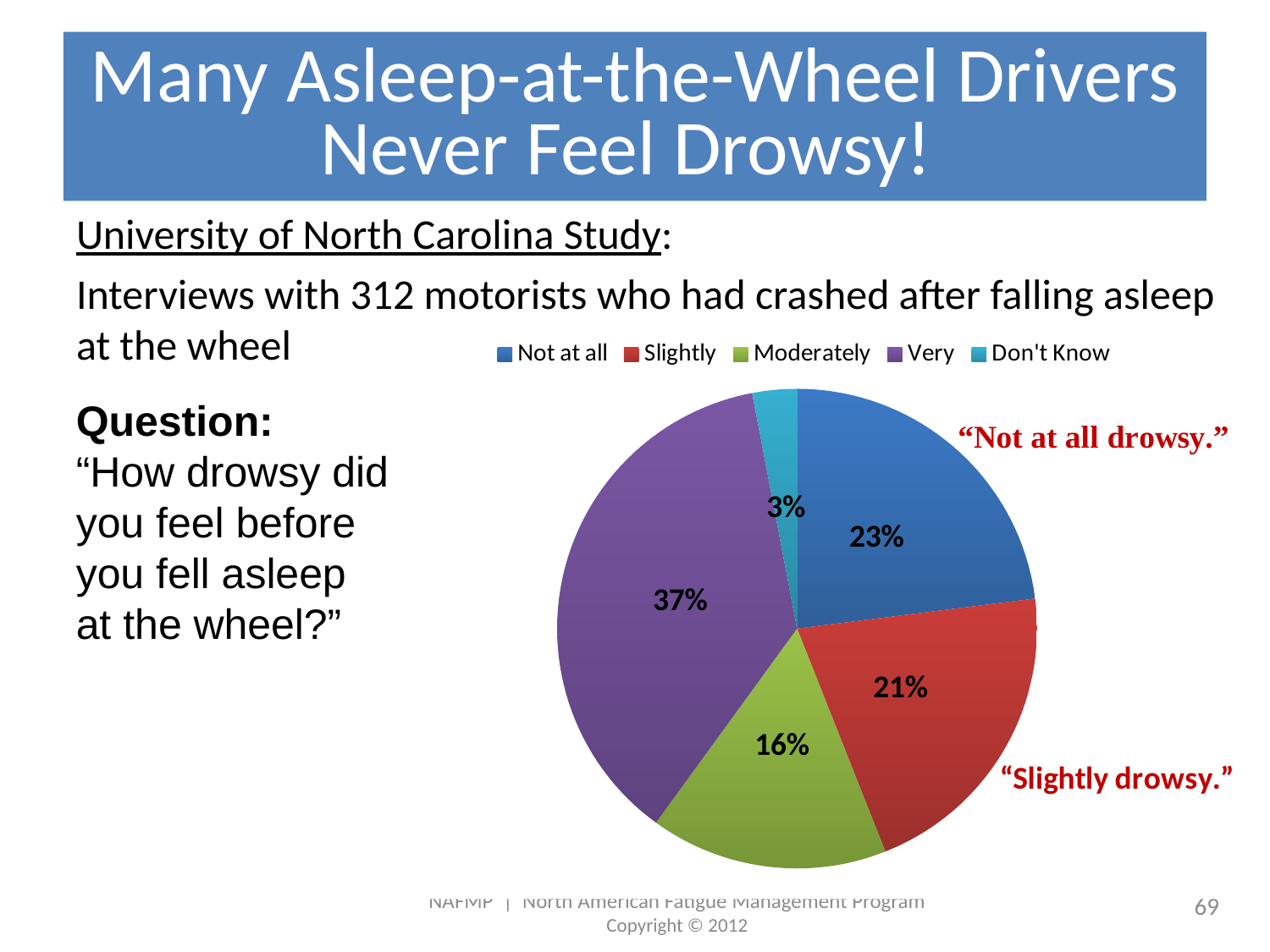
What percentage of the pie is the "Slightly" slice? 21% Which category has the smallest share of the pie? Don't Know What is the difference in percentage points between the "Very" slice and the "Not at all" slice? 14 What kind of chart is shown on the slide? pie chart How many categories does the legend list? 5 What percentage of the pie is the "Moderately" slice? 16% What colour is the "Very" slice of the pie? purple Which slice is larger, "Slightly" or "Moderately"? Slightly Which category has the largest share of the pie? Very What percentage of the pie is the "Not at all" slice? 23% What percentage of the pie is the "Very" slice? 37% What percentage of the pie is the "Don't Know" slice? 3%